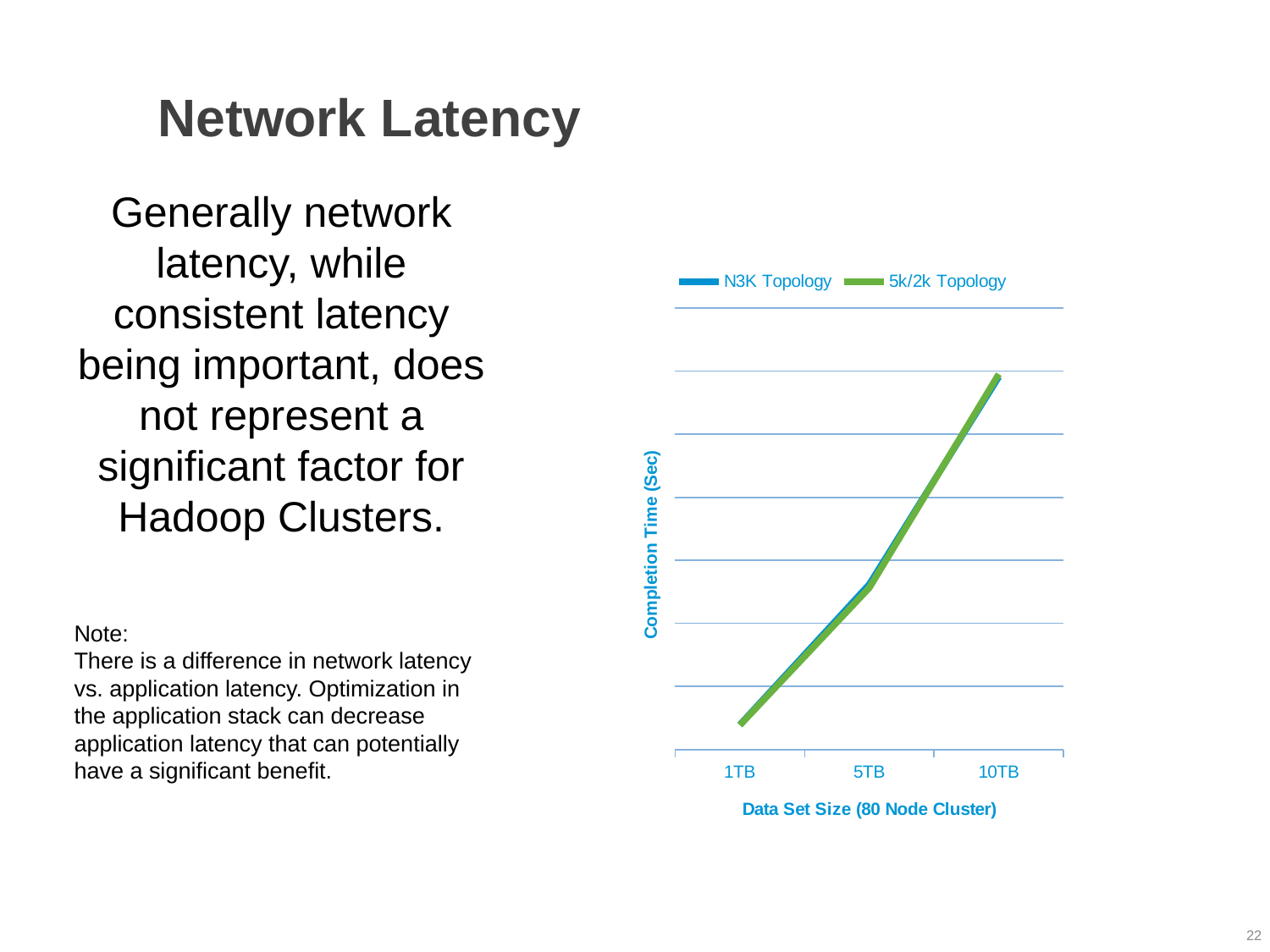
At which data set size is the completion time lowest for the 5k/2k Topology series? 1TB At which data set size is the completion time highest for the N3K Topology series? 10TB How many series does the chart legend list? 2 For the 5k/2k Topology series, is the completion time larger at 10TB or at 5TB? 10TB How many data set sizes are shown on the x axis of the chart? 3 Does completion time rise or fall as the data set size increases from 1TB to 10TB? rise What is the title of the y axis of the chart? Completion Time (Sec) What kind of chart is shown on the slide? line chart What are the two series named in the chart legend? N3K Topology and 5k/2k Topology For the N3K Topology series, is the completion time larger at 5TB or at 1TB? 5TB